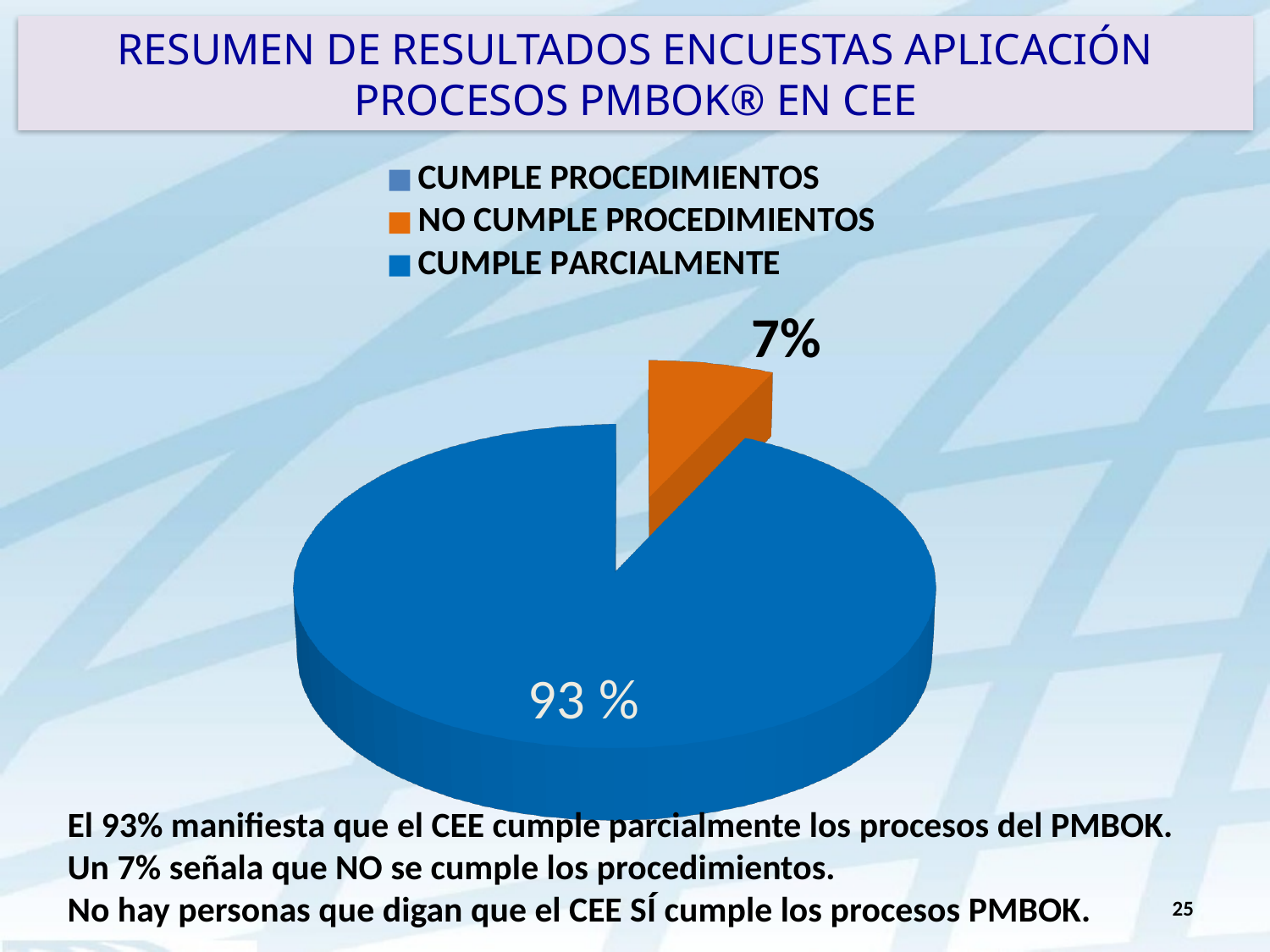
What is the difference in percentage points between the CUMPLE PARCIALMENTE slice and the NO CUMPLE PROCEDIMIENTOS slice? 86 Which legend entry has no visible slice in the pie? CUMPLE PROCEDIMIENTOS How many categories does the legend list? 3 How many slices are visible in the pie? 2 What share of the pie does the NO CUMPLE PROCEDIMIENTOS slice represent? 7% What percentage is shown for the NO CUMPLE PROCEDIMIENTOS slice? 7% What kind of chart is shown on the slide? pie chart Which is larger, the CUMPLE PARCIALMENTE slice or the NO CUMPLE PROCEDIMIENTOS slice? CUMPLE PARCIALMENTE Which category has the largest slice of the pie? CUMPLE PARCIALMENTE What percentage is shown for the CUMPLE PARCIALMENTE slice? 93 % What colour is the NO CUMPLE PROCEDIMIENTOS slice? orange Which of the two visible slices is smaller, NO CUMPLE PROCEDIMIENTOS or CUMPLE PARCIALMENTE? NO CUMPLE PROCEDIMIENTOS